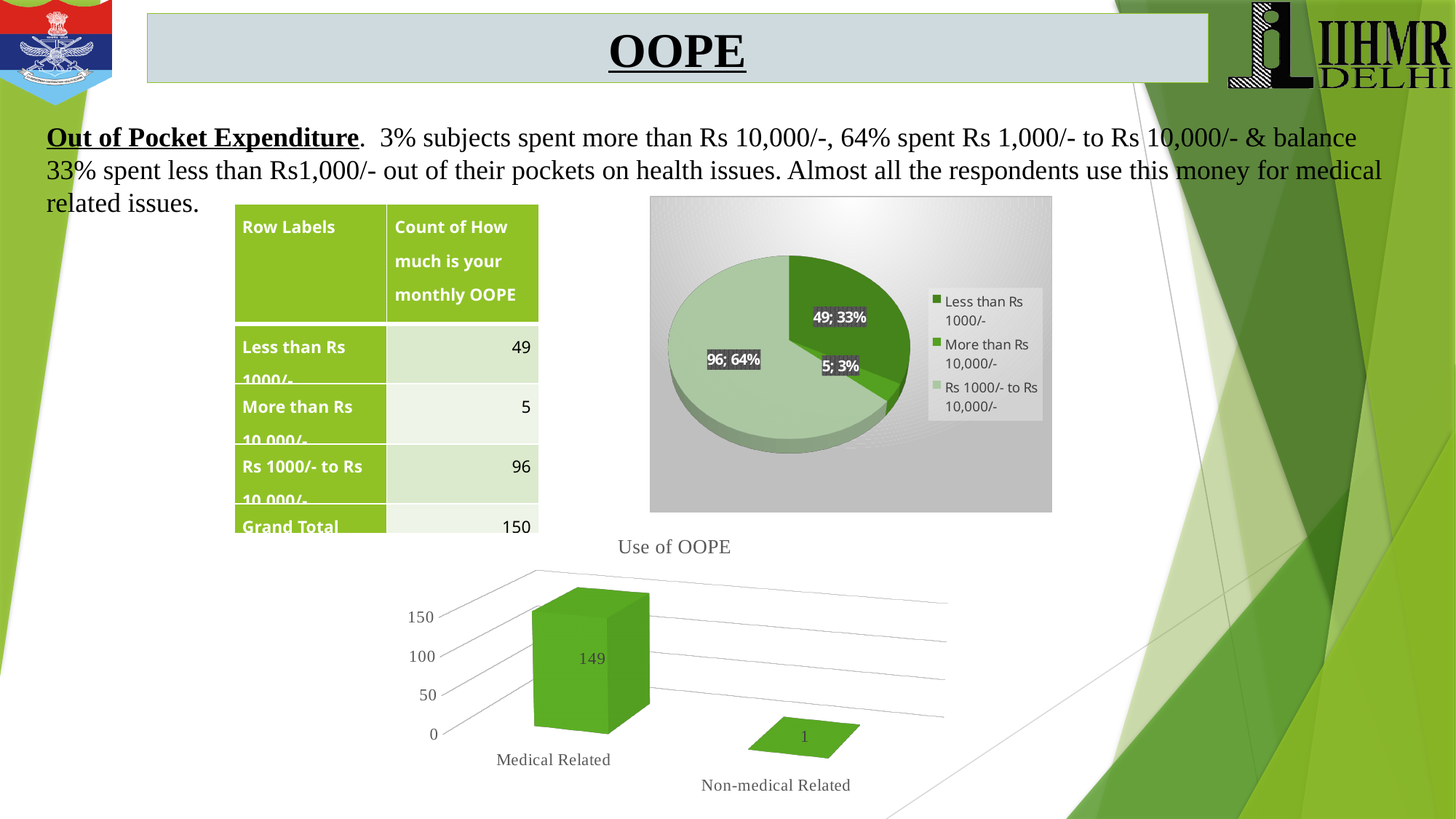
In the pie chart at the top right, what is the count for 'Rs 1000/- to Rs 10,000/-'? 96 In the 'Use of OOPE' chart, what is the value for 'Medical Related'? 149 In the 'Use of OOPE' chart, is the value for 'Medical Related' greater or less than 100? greater In the pie chart at the top right, what is the difference between the counts for 'Rs 1000/- to Rs 10,000/-' and 'Less than Rs 1000/-'? 47 How many categories does the legend of the pie chart at the top right list? 3 In the 'Use of OOPE' chart, what is the difference between 'Medical Related' and 'Non-medical Related'? 148 In the pie chart at the top right, what percentage share does 'More than Rs 10,000/-' have? 3% In the 'Use of OOPE' chart, what is the value for 'Non-medical Related'? 1 In the pie chart at the top right, which category has the largest slice? Rs 1000/- to Rs 10,000/- In the pie chart at the top right, what percentage share does 'Less than Rs 1000/-' have? 33% What kind of chart is the 'Use of OOPE' chart? Bar chart In the pie chart at the top right, which category has the smallest slice? More than Rs 10,000/-